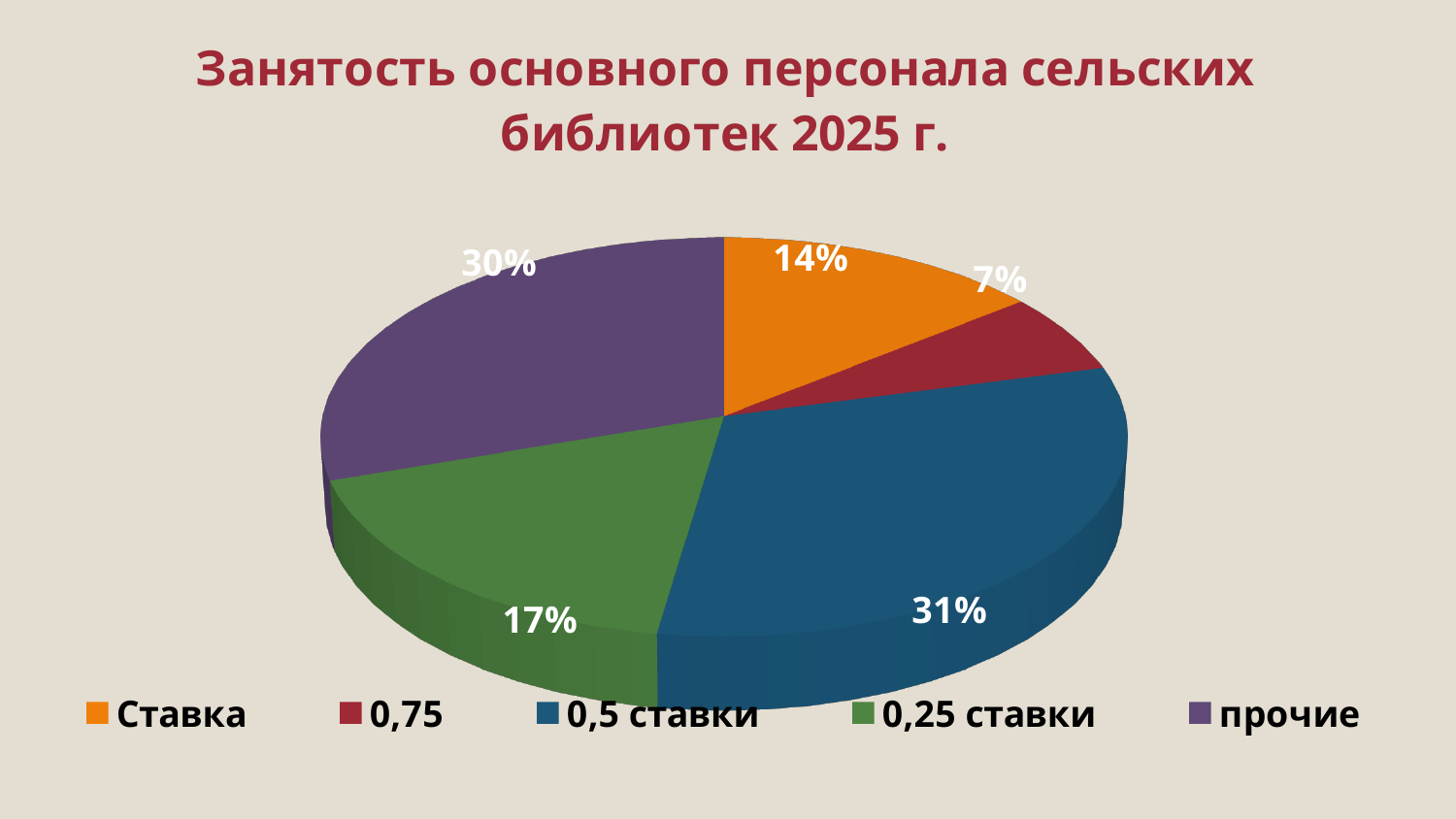
What is the value shown for "Ставка"? 14% What share of the pie does the "0,5 ставки" slice have? 31% What share of the pie does the "прочие" slice have? 30% How many categories does the legend list? 5 What is the title of the chart? Занятость основного персонала сельских библиотек 2025 г. What is the difference between the shares of "0,5 ставки" and "0,25 ставки"? 14% What kind of chart is shown on the slide? pie chart Which is larger, the share for "Ставка" or the share for "0,25 ставки"? 0,25 ставки What is the value shown for "0,75"? 7% Which category has the smallest slice of the pie? 0,75 Which category has the largest slice of the pie? 0,5 ставки What is the value shown for "0,25 ставки"? 17%